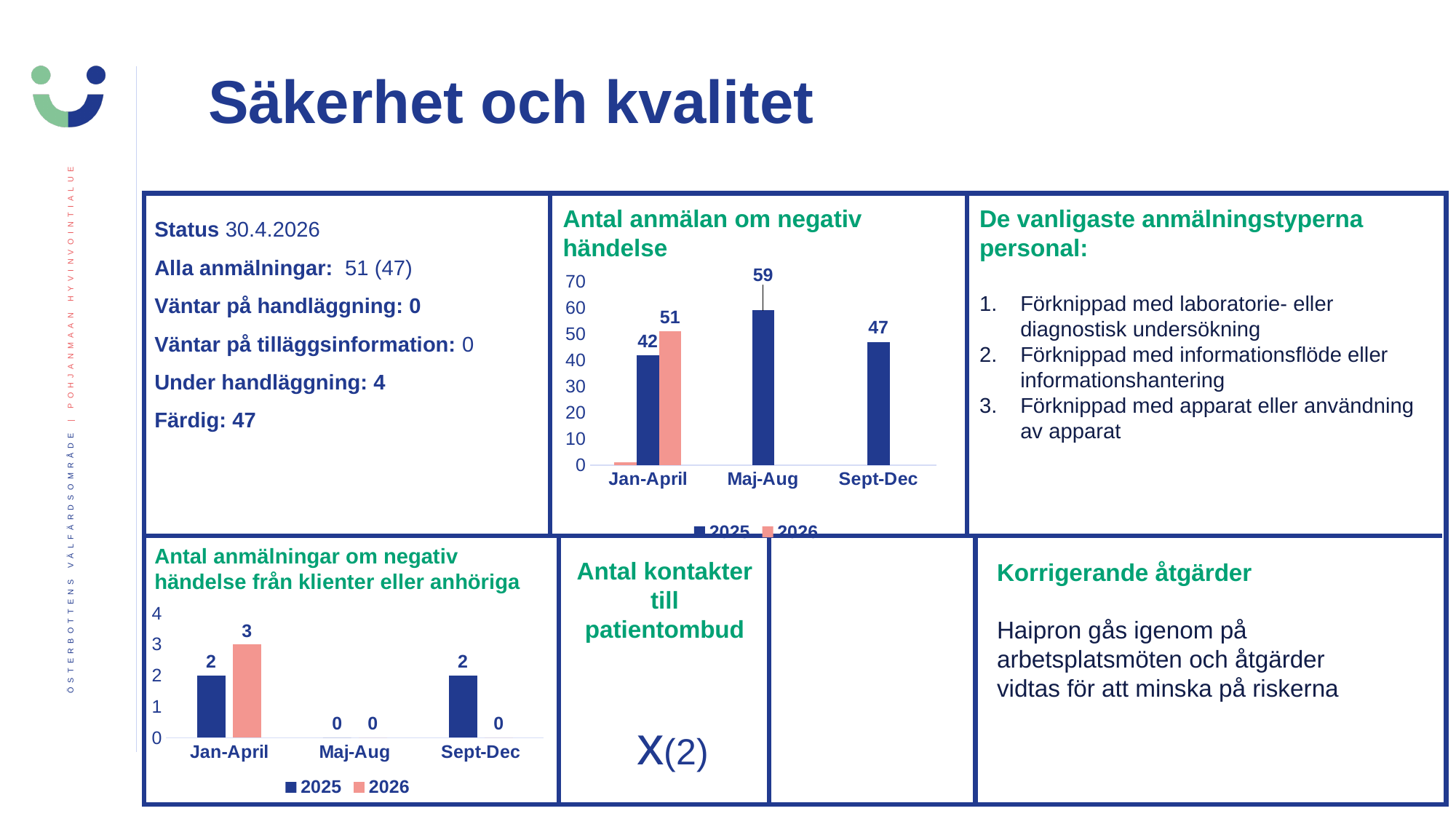
In the chart 'Antal anmälningar om negativ händelse från klienter eller anhöriga', what is the 2026 value for Jan-April? 3 In the chart 'Antal anmälan om negativ händelse', how many series does the legend list? 2 In the chart 'Antal anmälan om negativ händelse', what is the 2025 value for Maj-Aug? 59 In the chart 'Antal anmälan om negativ händelse', which period has the highest 2025 value? Maj-Aug In the chart 'Antal anmälan om negativ händelse', what is the 2026 value for Jan-April? 51 In the chart 'Antal anmälan om negativ händelse', is the 2025 value for Sept-Dec greater or less than 40? greater In the chart 'Antal anmälningar om negativ händelse från klienter eller anhöriga', which is larger for Jan-April, the 2025 value or the 2026 value? 2026 In the chart 'Antal anmälningar om negativ händelse från klienter eller anhöriga', how many periods are shown on the x axis? 3 What type of chart is 'Antal anmälningar om negativ händelse från klienter eller anhöriga'? Bar chart In the chart 'Antal anmälningar om negativ händelse från klienter eller anhöriga', what is the 2025 value for Sept-Dec? 2 In the chart 'Antal anmälan om negativ händelse', what is the difference between the 2026 and 2025 values for Jan-April? 9 In the chart 'Antal anmälan om negativ händelse', which period has the lowest 2025 value? Jan-April